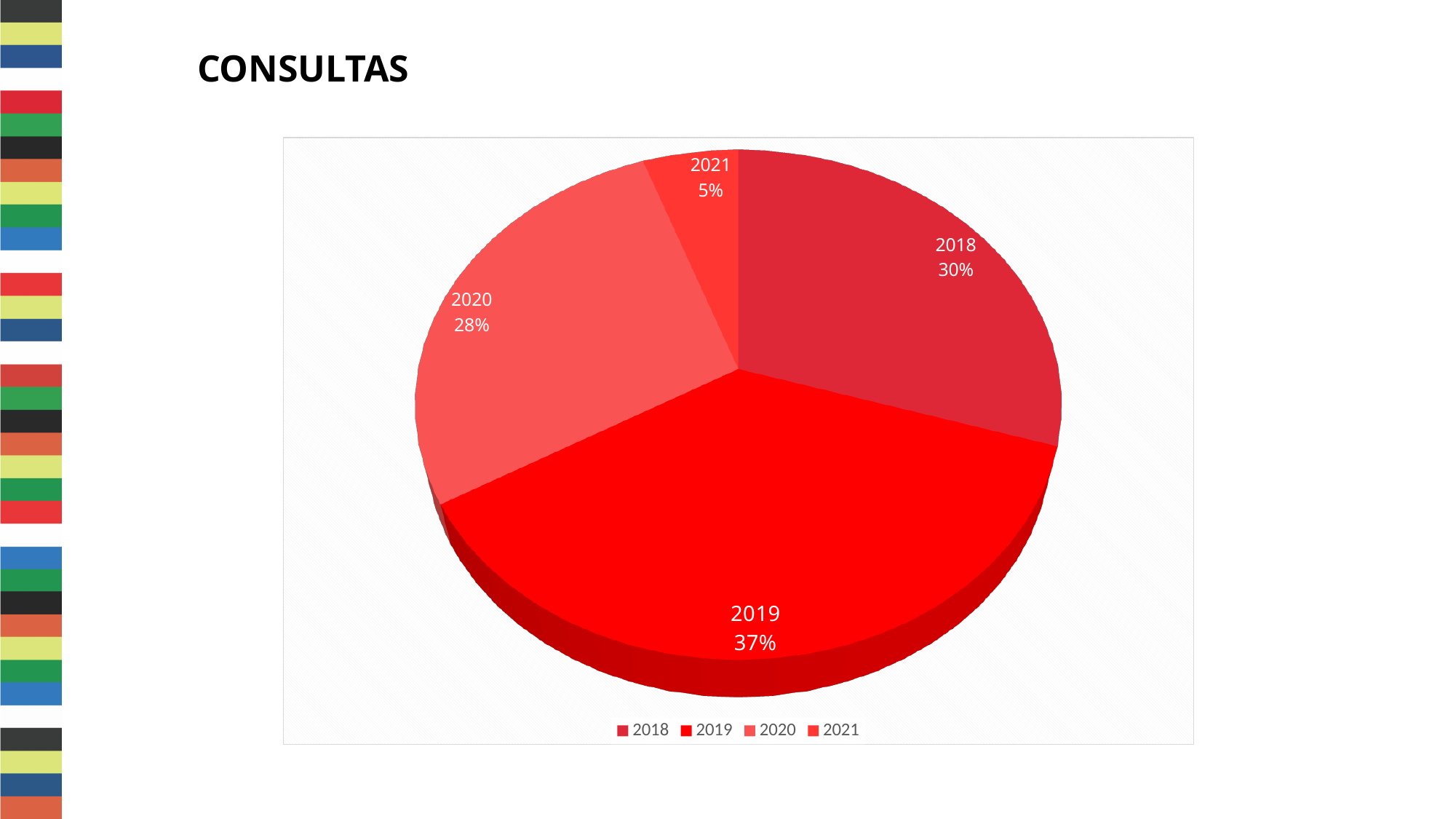
What is the difference in percentage points between the 2019 slice and the 2018 slice? 7 Which slice is larger, 2018 or 2020? 2018 Which year has the largest slice of the pie? 2019 What is the difference in percentage points between the 2020 slice and the 2021 slice? 23 What type of chart is shown on the slide? pie chart What share of the pie does 2019 represent? 37% Which year has the smallest slice of the pie? 2021 How many slices does the pie chart have? 4 What share of the pie does 2020 represent? 28% What is the title of the slide containing the pie chart? CONSULTAS What share of the pie does 2018 represent? 30%